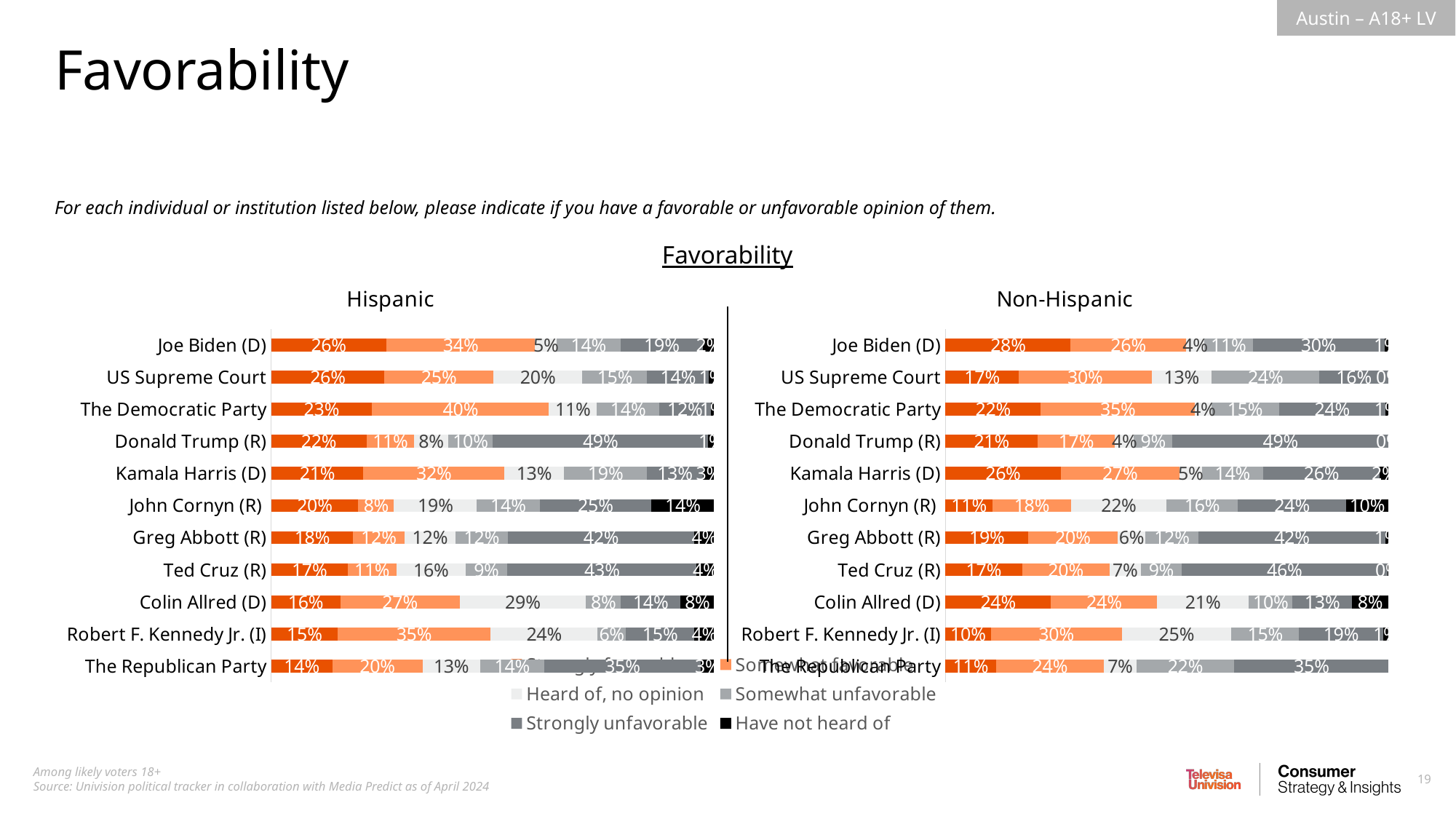
In the Hispanic chart, how many individuals or institutions are listed? 11 In the Hispanic chart, what is the Have not heard of value for John Cornyn (R)? 14% In the Hispanic chart, what is the Strongly unfavorable value for The Republican Party? 35% In the Non-Hispanic chart, what is the Somewhat unfavorable value for the US Supreme Court? 24% In the Hispanic chart, what is the Somewhat favorable value for The Democratic Party? 40% In the Hispanic chart, which individual or institution has the highest Strongly unfavorable value? Donald Trump (R) How many series does the legend list? 6 What kind of chart is used for the Hispanic and Non-Hispanic favorability data? Stacked bar chart In the Non-Hispanic chart, what is the Strongly unfavorable value for Ted Cruz (R)? 46% In the Hispanic chart, what is the difference between the Somewhat favorable values for The Democratic Party and The Republican Party? 20 percentage points In the Hispanic chart, which individual or institution has the highest Heard of, no opinion value? Colin Allred (D) In the Non-Hispanic chart, who has the larger Heard of, no opinion value: Robert F. Kennedy Jr. (I) or Colin Allred (D)? Robert F. Kennedy Jr. (I)